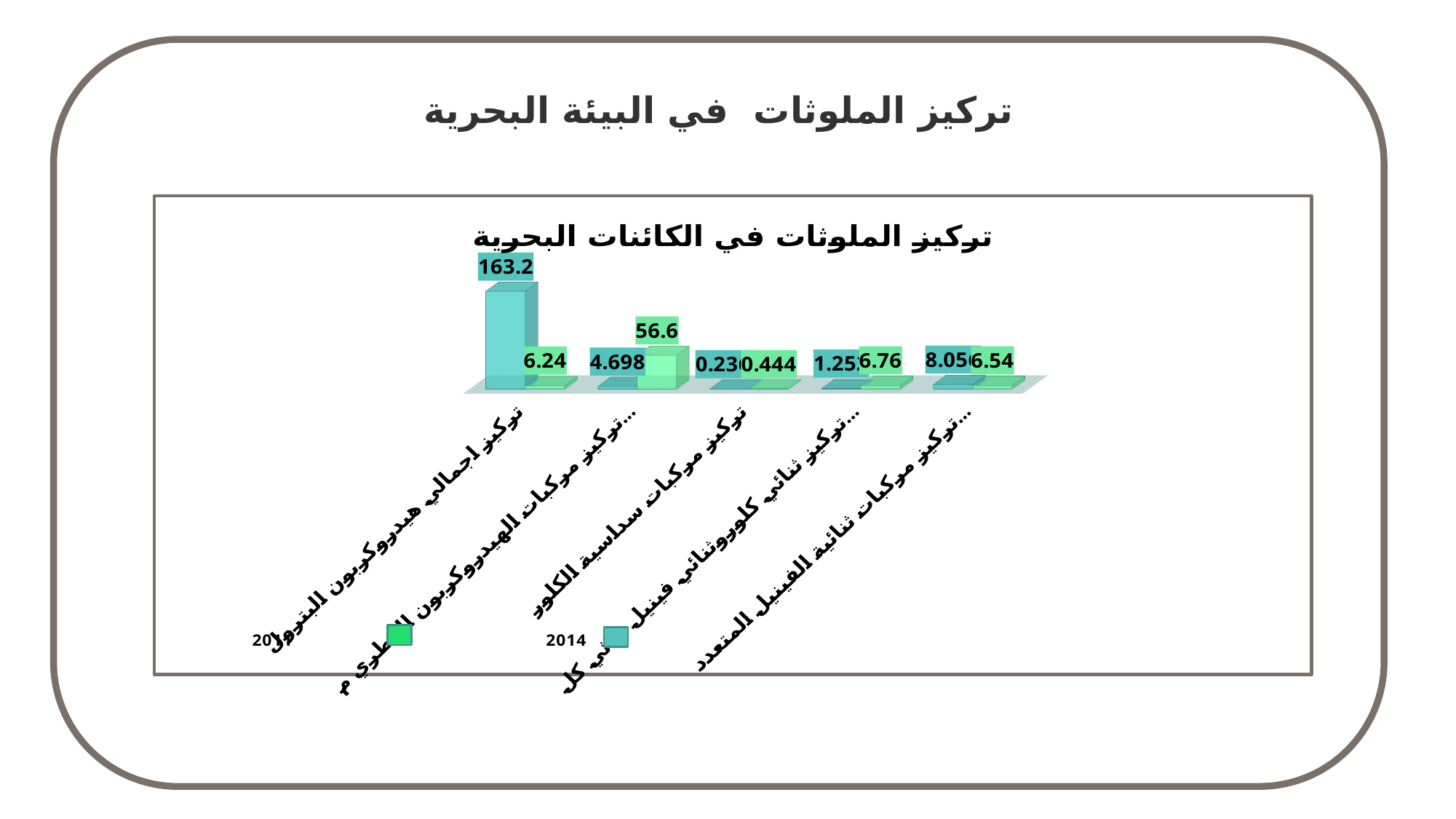
In the second category from the left (تركيز مركبات الهيدروكربون...), which bar is taller, the 2014 bar or the green bar? the green bar Which category has the highest 2014 value? تركيز اجمالي هيدروكربون البترول How many categories are plotted along the x axis of the chart? 5 What is the title of the chart? تركيز الملوثات في الكائنات البحرية What kind of chart is shown on the slide? bar chart How many series does the chart's legend list? 2 What is the value of the green (non-2014) series for تركيز اجمالي هيدروكربون البترول? 6.24 What is the 2014 value for تركيز اجمالي هيدروكربون البترول? 163.2 What is the difference between the 2014 value and the green series value for تركيز اجمالي هيدروكربون البترول? 156.96